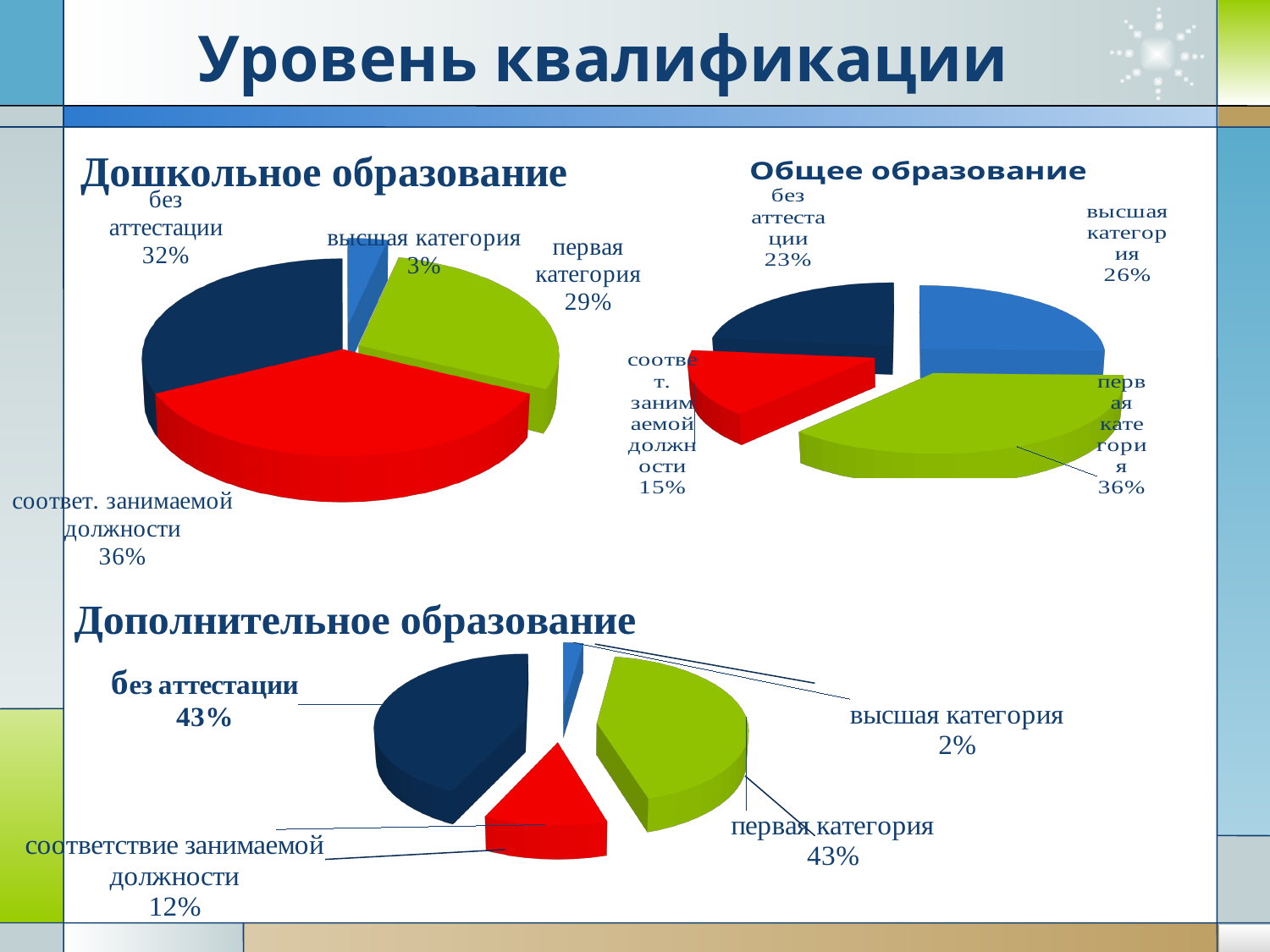
What type of chart is used for 'Дошкольное образование'? pie chart In the 'Дошкольное образование' chart, what share is labelled 'соответ. занимаемой должности'? 36% In the 'Общее образование' chart, which category has the largest share? первая категория In the 'Дополнительное образование' chart, which category has the smallest share? высшая категория In the 'Общее образование' chart, how many slices does the pie have? 4 How many charts are shown on the slide? 3 In the 'Общее образование' chart, which is larger: 'без аттестации' or 'соответ. занимаемой должности'? без аттестации In the 'Дошкольное образование' chart, which category has the smallest share? высшая категория In the 'Дошкольное образование' chart, what is the difference between 'без аттестации' and 'первая категория'? 3% In the 'Дополнительное образование' chart, what share is labelled 'соответствие занимаемой должности'? 12% In the 'Общее образование' chart, what share is labelled 'высшая категория'? 26% In the 'Дополнительное образование' chart, what is the difference between 'без аттестации' and 'соответствие занимаемой должности'? 31%